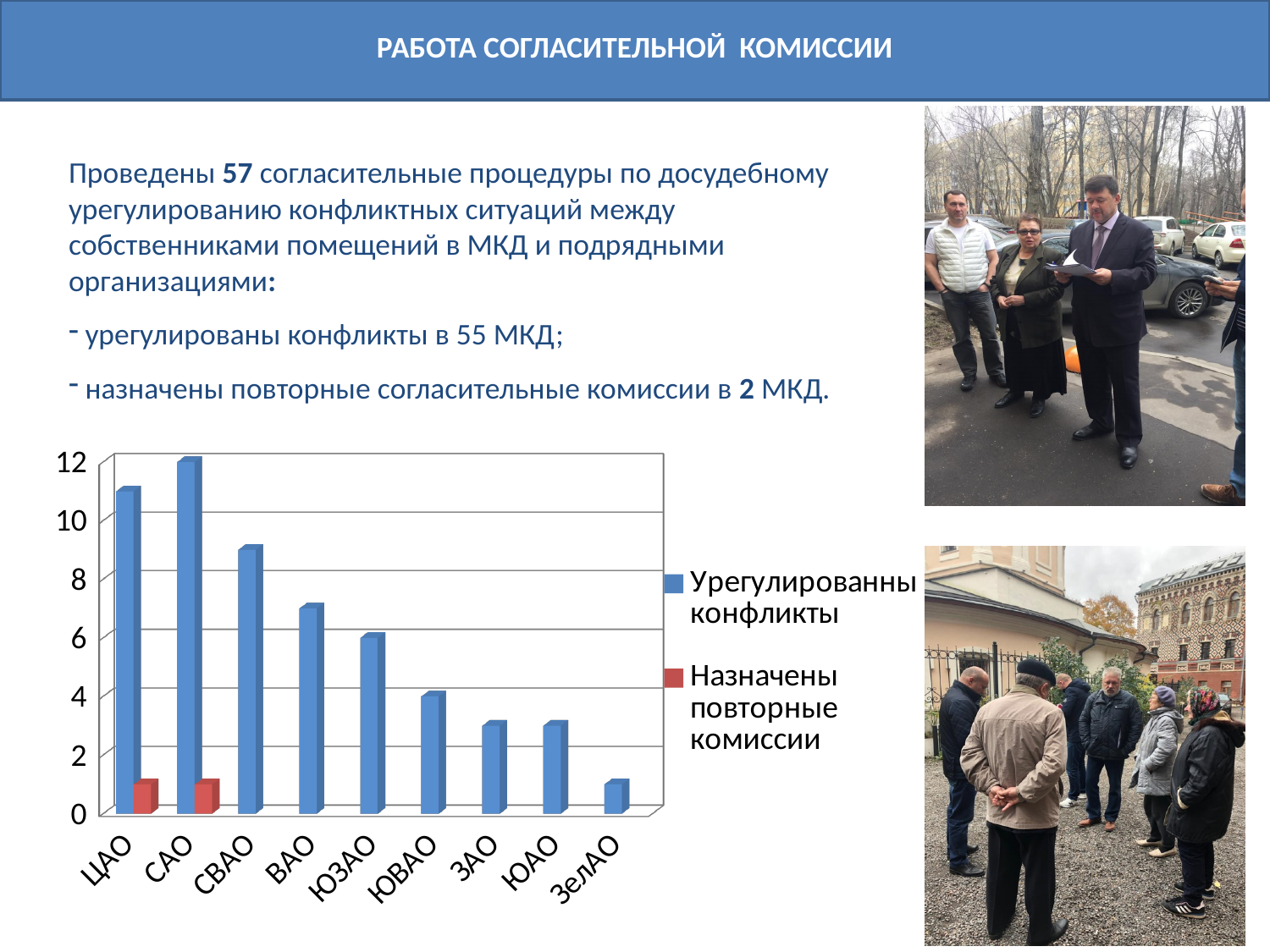
Do the values for Урегулированные конфликты generally rise or fall from ЦАО to ЗелАО along the x axis? fall Is the value for Урегулированные конфликты in ЦАО greater or less than 10? greater Is the value for Урегулированные конфликты in ЮЗАО greater or less than 8? less How many series does the chart legend list? 2 Is the value for Урегулированные конфликты in ЗелАО greater or less than 2? less Which series is shown in red in the chart legend? Назначены повторные комиссии Which district has the lowest value for Урегулированные конфликты? ЗелАО How many categories (districts) are shown on the x axis of the chart? 9 Which district has the highest value for Урегулированные конфликты? САО Which has a larger value for Урегулированные конфликты, ЦАО or СВАО? ЦАО What kind of chart is shown on the slide? bar chart